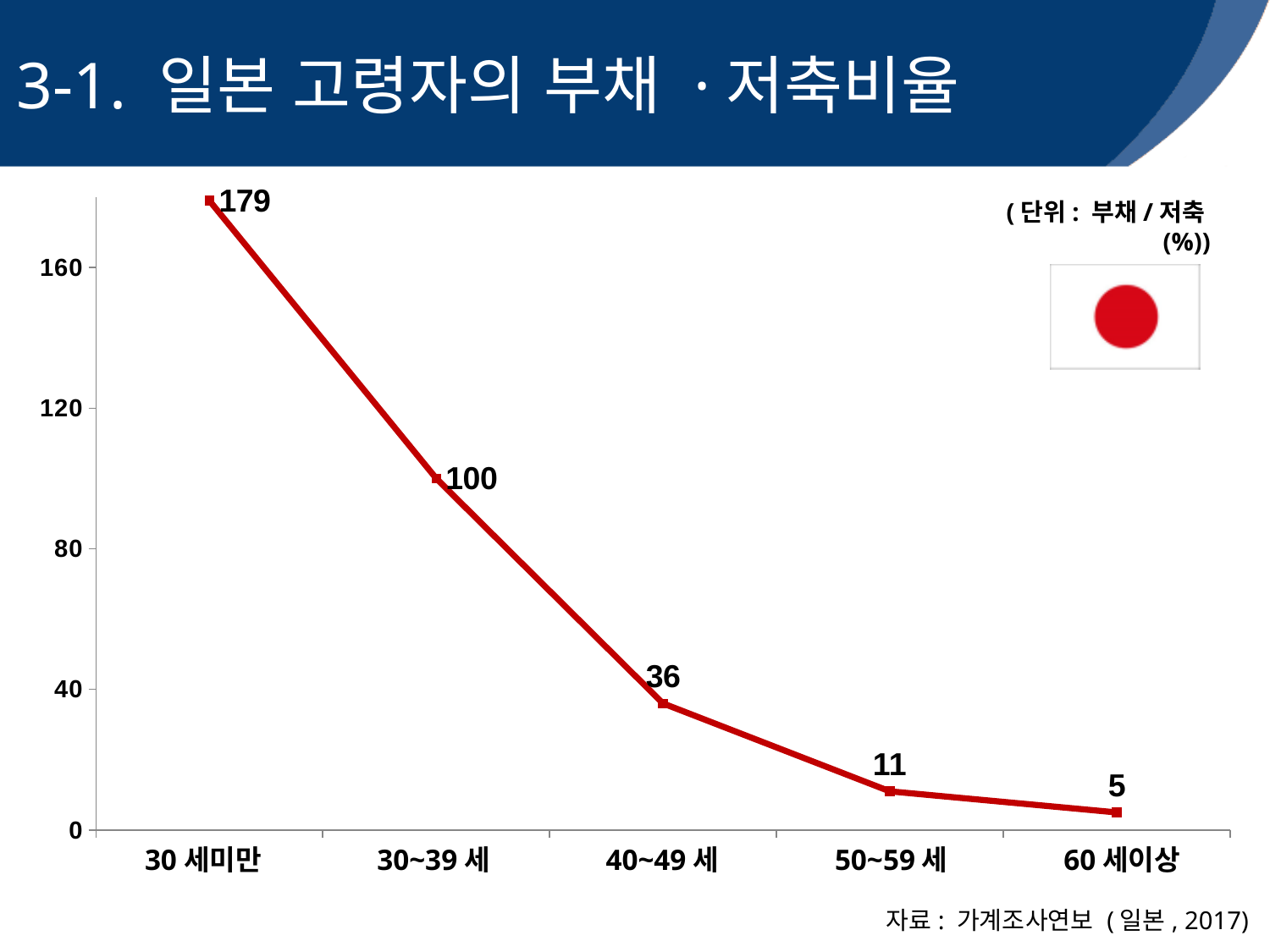
Which age group has the lowest value? 60 세이상 What kind of chart is shown on the slide? line chart Is the value for 30~39 세 greater or less than 120? less What is the value for 30 세미만? 179 What is the value for 40~49 세? 36 Which is larger, the value for 30~39 세 or the value for 40~49 세? 30~39 세 What is the difference between the values for 50~59 세 and 60 세이상? 6 Which age group has the highest value? 30 세미만 What is the value for 60 세이상? 5 Do the values rise or fall as age increases along the x axis? fall What is the difference between the values for 30 세미만 and 30~39 세? 79 How many age groups are plotted on the chart? 5